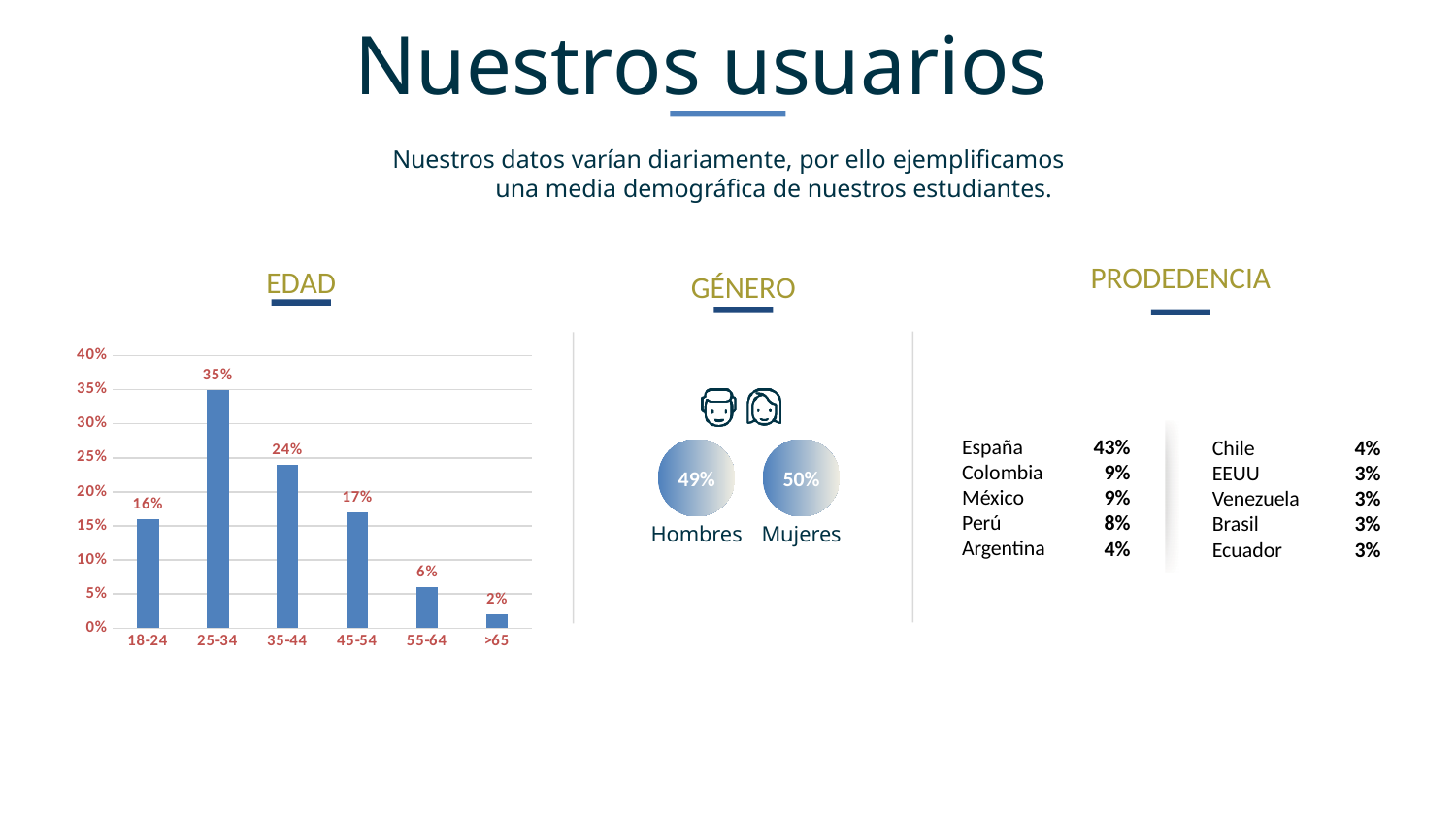
In the EDAD chart, what is the value for the 25-34 age group? 35% In the EDAD chart, what is the difference between the 45-54 and 18-24 age groups? 1% In the EDAD chart, what is the difference between the 25-34 and 35-44 age groups? 11% In the EDAD chart, what is the value for the >65 age group? 2% In the EDAD chart, do the values rise or fall from the 25-34 group to the >65 group? fall In the EDAD chart, which is larger, the value for 35-44 or the value for 45-54? 35-44 In the EDAD chart, is the value for 25-34 greater or less than 30%? greater How many age groups are shown in the EDAD chart? 6 Which age group has the lowest value in the EDAD chart? >65 Which age group has the highest value in the EDAD chart? 25-34 What kind of chart is the EDAD chart? bar chart In the EDAD chart, what is the value for the 55-64 age group? 6%